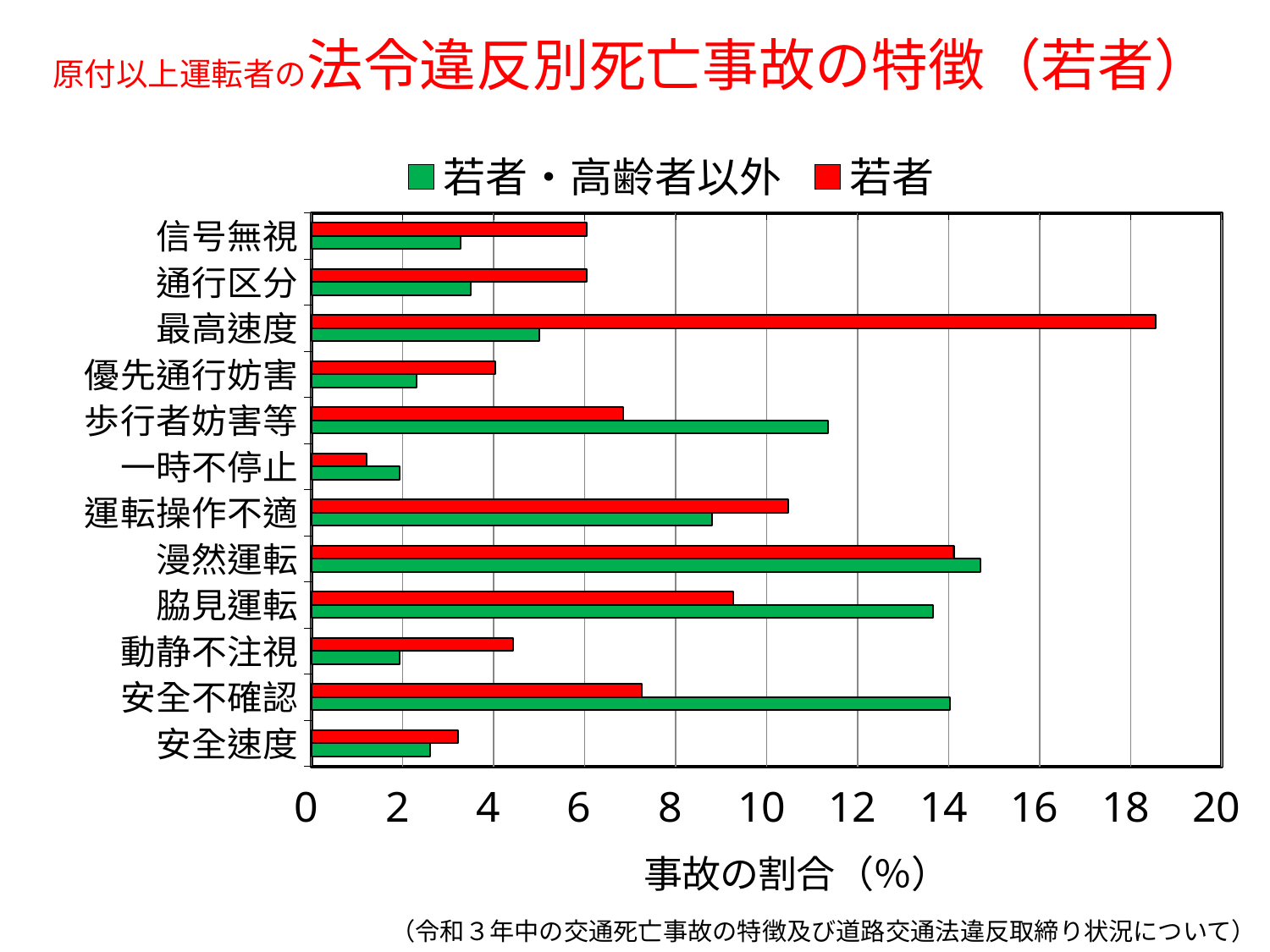
For 最高速度, which series has the larger value, 若者 or 若者・高齢者以外? 若者 What colour represents the 若者 series in the chart? red Which category has the lowest value for the 若者 series? 一時不停止 Is the 若者 value for 最高速度 greater or less than 18? greater What kind of chart is shown on the slide? bar chart How many violation categories are listed on the vertical axis of the chart? 12 Which category has the highest value for the 若者 series? 最高速度 Is the 若者・高齢者以外 value for 歩行者妨害等 greater or less than 10? greater How many series does the chart's legend list? 2 Is the 若者 value for 一時不停止 greater or less than 2? less For 安全不確認, which series has the larger value, 若者 or 若者・高齢者以外? 若者・高齢者以外